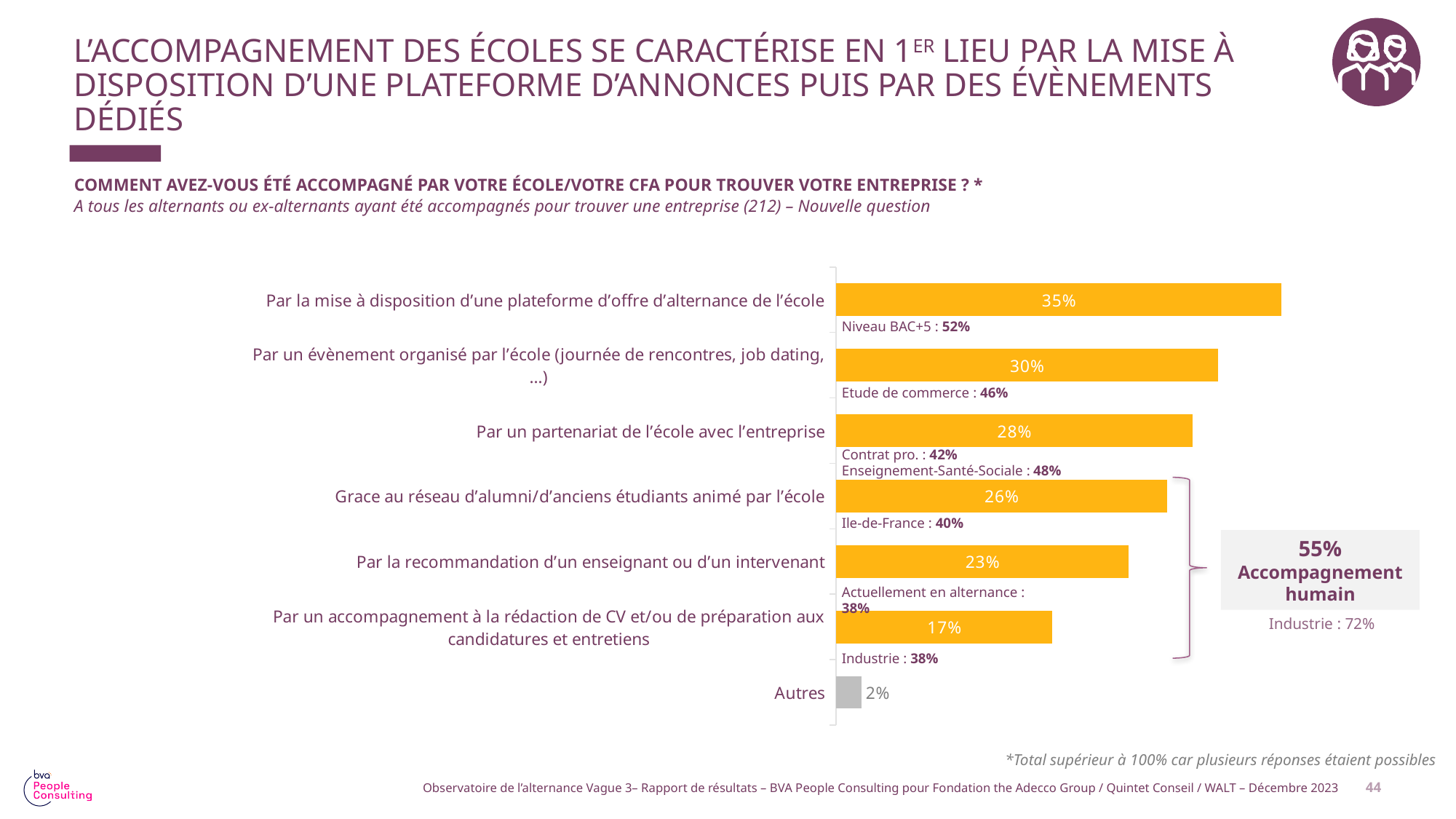
What percentage of respondents were accompanied through the school's platform of work-study offers (plateforme d'offre d'alternance)? 35% What percentage is given in the box labelled 'Accompagnement humain' next to the bracket? 55% Which category has the lowest value in the chart? Autres Which is larger: the value for 'Par la recommandation d'un enseignant ou d'un intervenant' or the value for 'Par un accompagnement à la rédaction de CV et/ou de préparation aux candidatures et entretiens'? Par la recommandation d'un enseignant ou d'un intervenant What kind of chart is shown on the slide? Bar chart What percentage corresponds to 'Par un partenariat de l'école avec l'entreprise'? 28% How many categories are plotted in the bar chart? 7 What is the value shown for 'Par un accompagnement à la rédaction de CV et/ou de préparation aux candidatures et entretiens'? 17% Do the bar values increase or decrease from the top category to the bottom category? Decrease What is the value for 'Par un évènement organisé par l'école (journée de rencontres, job dating, …)'? 30% Which category has the highest value in the chart? Par la mise à disposition d'une plateforme d'offre d'alternance de l'école What is the difference between the value for the school's platform (35%) and the value for the alumni network (26%)? 9 points